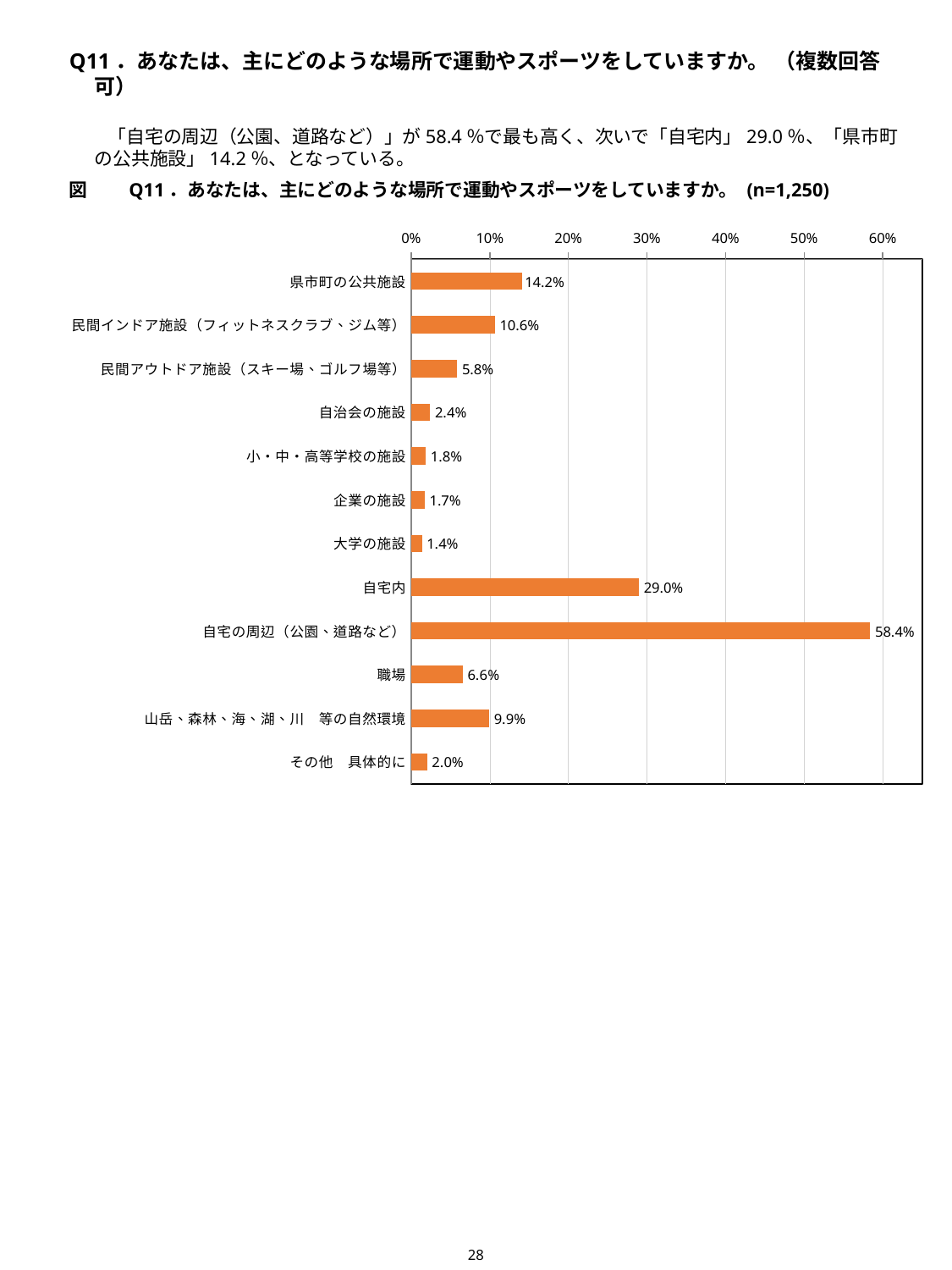
Which category has the lowest value? 大学の施設 What is the value for 民間アウトドア施設（スキー場、ゴルフ場等）? 5.8% What is the value for 山岳、森林、海、湖、川 等の自然環境? 9.9% What is the value for 県市町の公共施設? 14.2% What is the difference between the values for 自宅の周辺（公園、道路など） and 自宅内? 29.4% Which category has the highest value? 自宅の周辺（公園、道路など） What is the value for 自宅内? 29.0% What kind of chart is shown? bar chart Which is larger, the value for 民間インドア施設（フィットネスクラブ、ジム等） or the value for 職場? 民間インドア施設（フィットネスクラブ、ジム等） Is the value for 自宅内 greater or less than 20%? greater How many categories are shown in the chart? 12 What is the sample size (n) shown in the chart title? 1,250